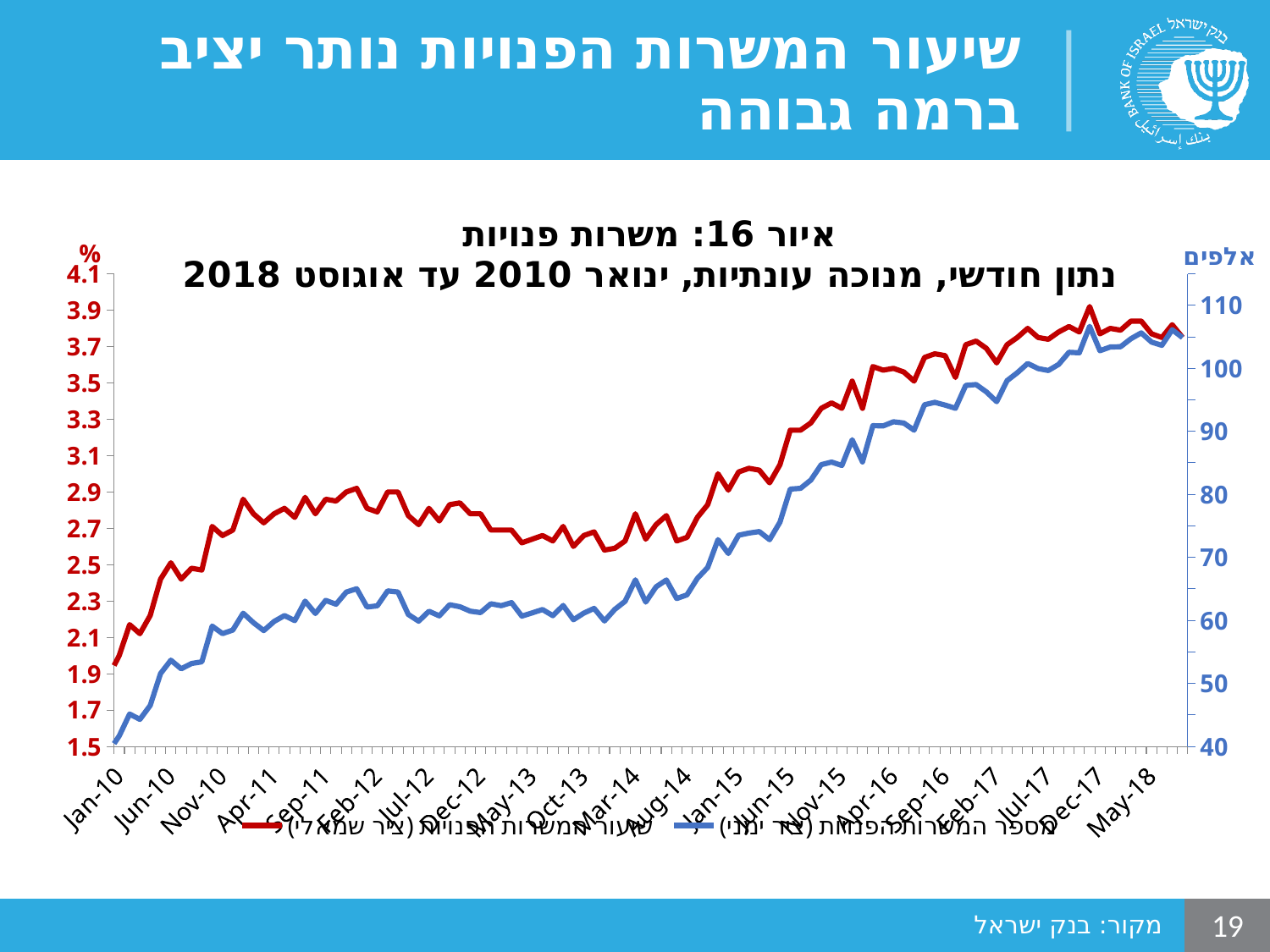
Is the value of the red line (vacancy rate, left axis) at Jan-10 greater or less than 2.1? less What unit is shown at the top of the right-hand axis? אלפים Is the value of the red line (left axis) at May-18 greater or less than 3.5? greater Is the value of the blue line (right axis) at Oct-13 greater or less than 70? less How many series does the chart plot? 2 What is the title of the chart? איור 16: משרות פנויות נתון חודשי, מנוכה עונתיות, ינואר 2010 עד אוגוסט 2018 What kind of chart is shown on the slide? line chart Overall, do the values of the red line rise or fall from Jan-10 to May-18? rise Does the red line rise or fall between Feb-12 and Oct-13? fall